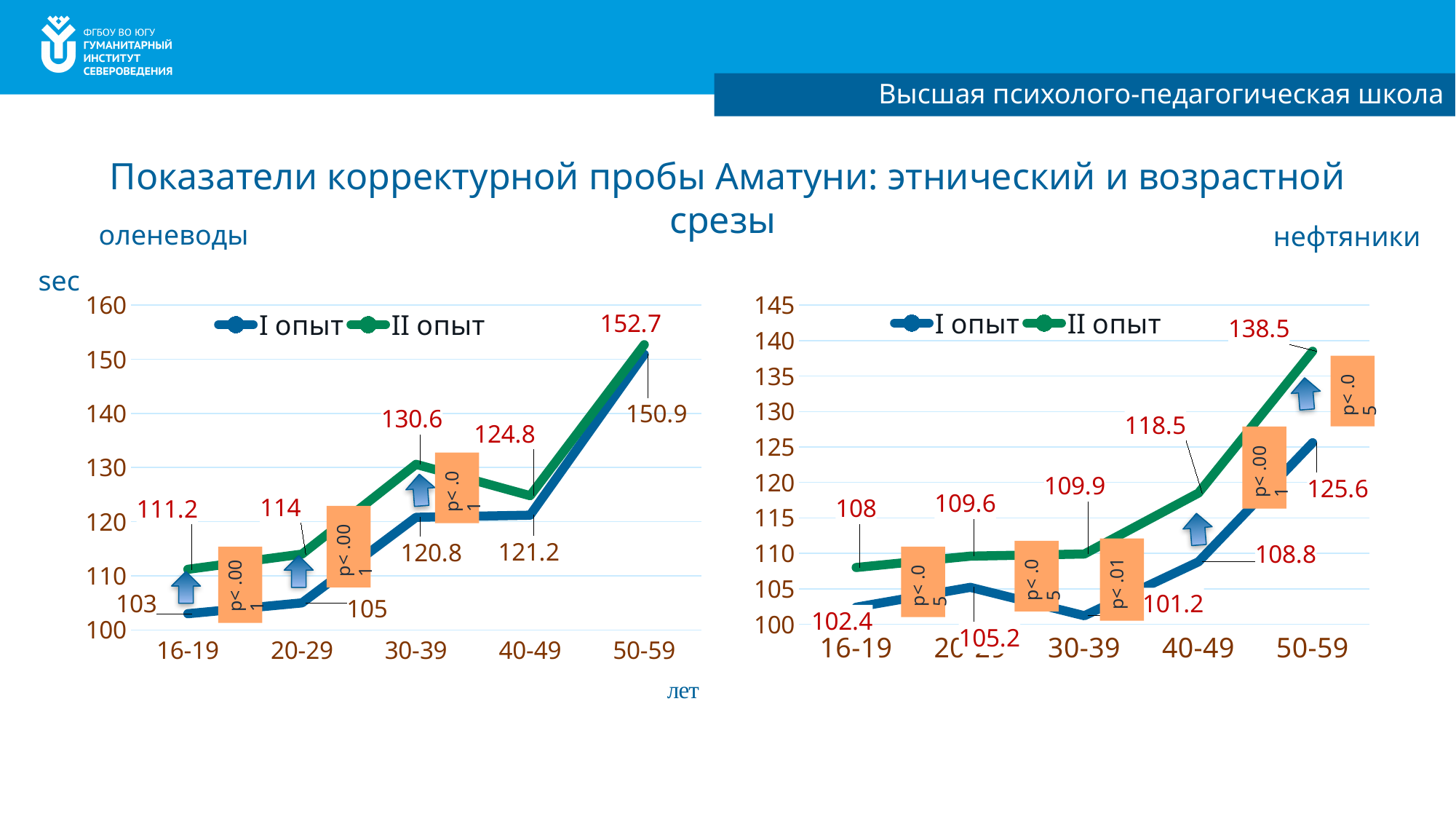
In the right chart (нефтяники), which age group has the lowest value for I опыт? 30-39 In the left chart (оленеводы), what is the difference between II опыт and I опыт for the 16-19 age group? 8.2 In the left chart (оленеводы), which age group has the highest value for I опыт? 50-59 In the right chart (нефтяники), what is the value of I опыт for the 50-59 age group? 125.6 In the left chart (оленеводы), what is the value of I опыт for the 30-39 age group? 120.8 In the left chart (оленеводы), which is larger for the 40-49 age group: I опыт or II опыт? II опыт How many series does the legend of the left chart (оленеводы) list? 2 How many age groups are shown on the x axis of the right chart (нефтяники)? 5 In the left chart (оленеводы), what is the value of II опыт for the 50-59 age group? 152.7 What type of chart is the right chart (нефтяники)? Line chart In the right chart (нефтяники), what is the value of II опыт for the 40-49 age group? 118.5 In the right chart (нефтяники), what is the difference between II опыт and I опыт for the 50-59 age group? 12.9